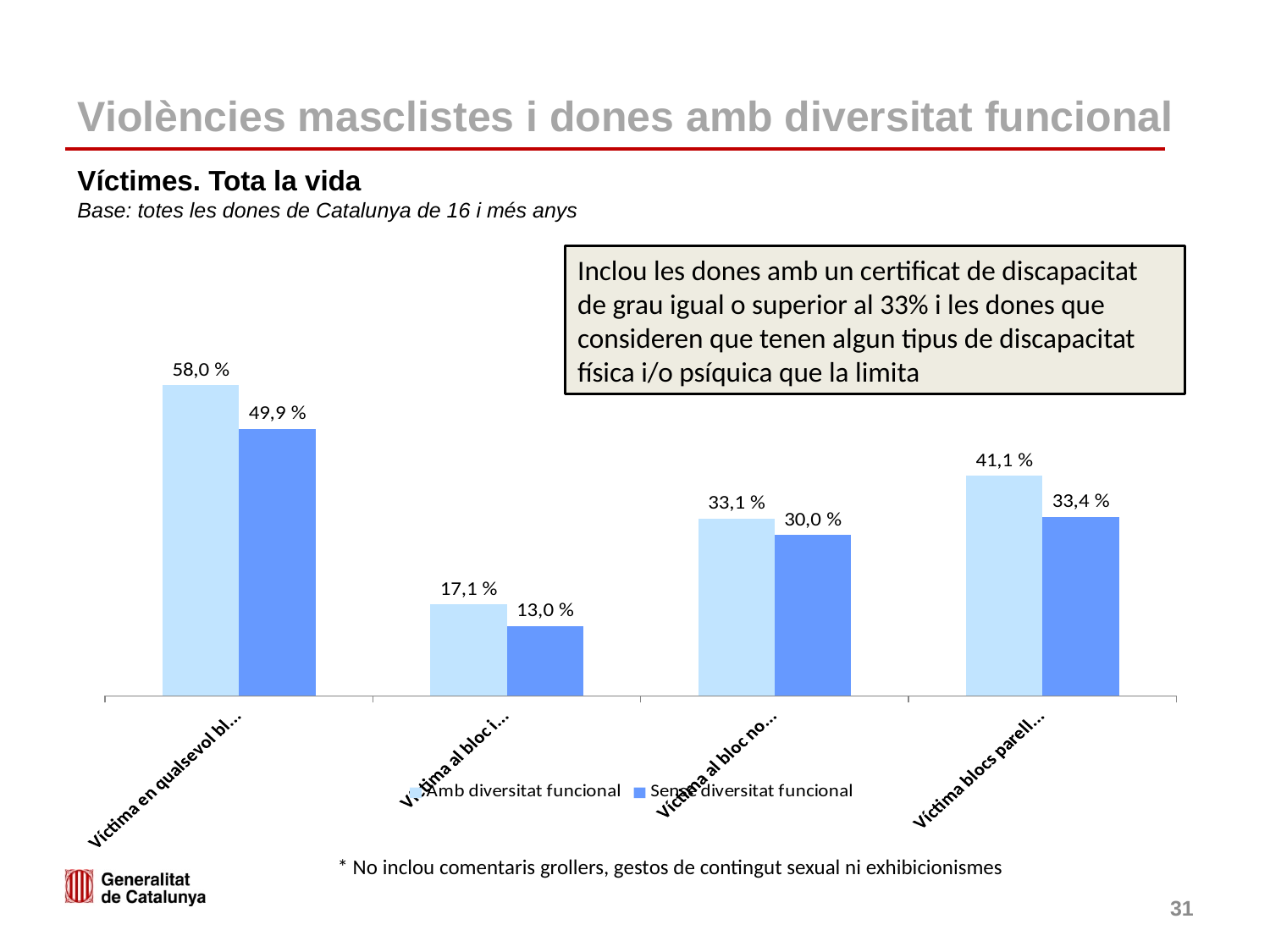
Which category has the highest value for 'Amb diversitat funcional'? Víctima en qualsevol bl... (the first category) What is the value for 'Amb diversitat funcional' in the fourth category (Víctima blocs parell...)? 41,1 % How many categories are plotted along the x axis of the chart? 4 In the third category (Víctima al bloc no...), which series has the larger value, 'Amb diversitat funcional' or 'Sense diversitat funcional'? Amb diversitat funcional Which category has the lowest value for 'Sense diversitat funcional'? Víctima al bloc i... (the second category) What are the two series names listed in the chart legend? Amb diversitat funcional; Sense diversitat funcional What type of chart is shown on the slide? bar chart What is the value for 'Sense diversitat funcional' in the second category (Víctima al bloc i...)? 13,0 % How many series does the chart legend list? 2 In the first category (Víctima en qualsevol bl...), what is the difference between the 'Amb diversitat funcional' and 'Sense diversitat funcional' values? 8,1 % What is the value for 'Sense diversitat funcional' in the third category (Víctima al bloc no...)? 30,0 % What is the value for 'Amb diversitat funcional' in the first category (Víctima en qualsevol bl...)? 58,0 %